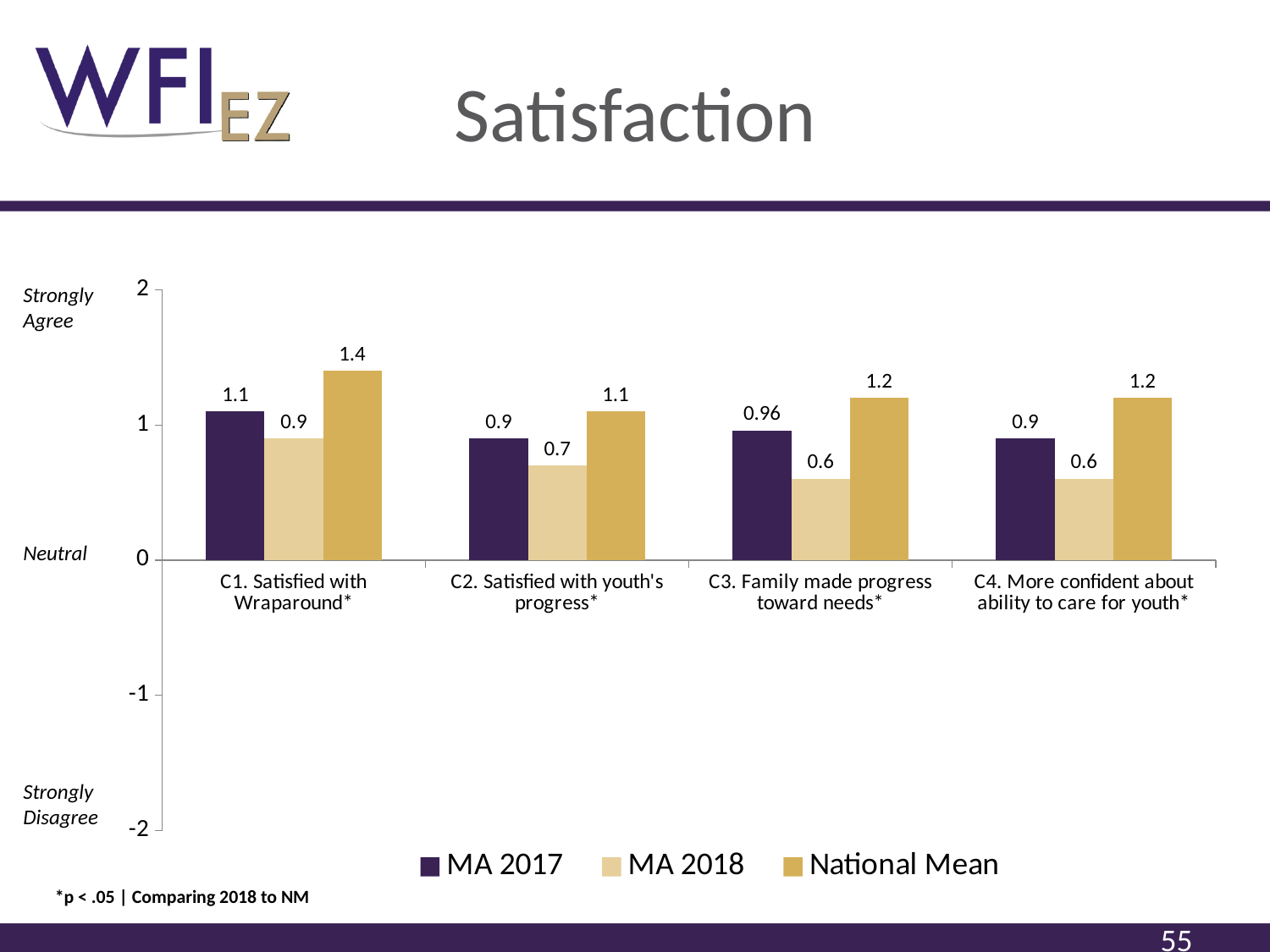
What is the difference between the National Mean and MA 2018 values for C1. Satisfied with Wraparound? 0.5 What is the title of the slide? Satisfaction What is the MA 2018 value for C2. Satisfied with youth's progress? 0.7 What is the MA 2017 value for C3. Family made progress toward needs? 0.96 What is the National Mean value for C3. Family made progress toward needs? 1.2 What kind of chart is shown on the slide? Bar chart What is the MA 2017 value for C1. Satisfied with Wraparound? 1.1 Which category has the lowest MA 2018 value? C3. Family made progress toward needs and C4. More confident about ability to care for youth (both 0.6) How many series does the legend list? 3 Which is larger for C4. More confident about ability to care for youth: the MA 2017 value or the MA 2018 value? MA 2017 Which category has the highest National Mean value? C1. Satisfied with Wraparound How many categories are shown on the x axis? 4